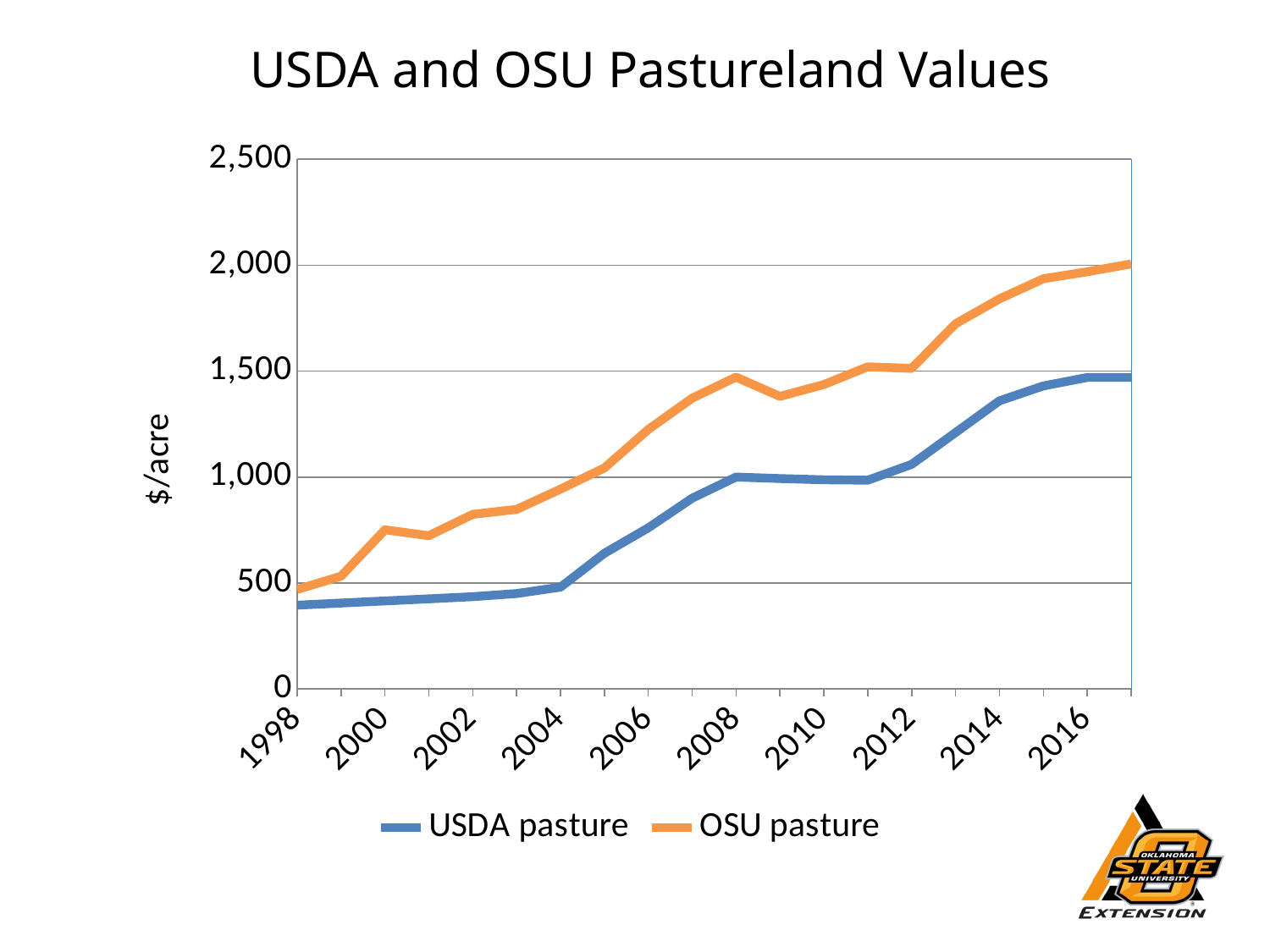
Is the OSU pasture value in 2010 greater or less than 1,500? less What is the label on the vertical axis? $/acre Is the OSU pasture value in 2014 greater or less than 1,500? greater What is the title of the chart? USDA and OSU Pastureland Values Is the USDA pasture value in 2006 greater or less than 500? greater What kind of chart is shown on the slide? line chart How many series does the legend list? 2 In which year shown on the x axis is the USDA pasture value lowest? 1998 Do the USDA pasture values generally rise or fall from 1998 to 2016? rise In 2010, which is larger, the USDA pasture value or the OSU pasture value? OSU pasture Which series is plotted higher across the whole chart, USDA pasture or OSU pasture? OSU pasture